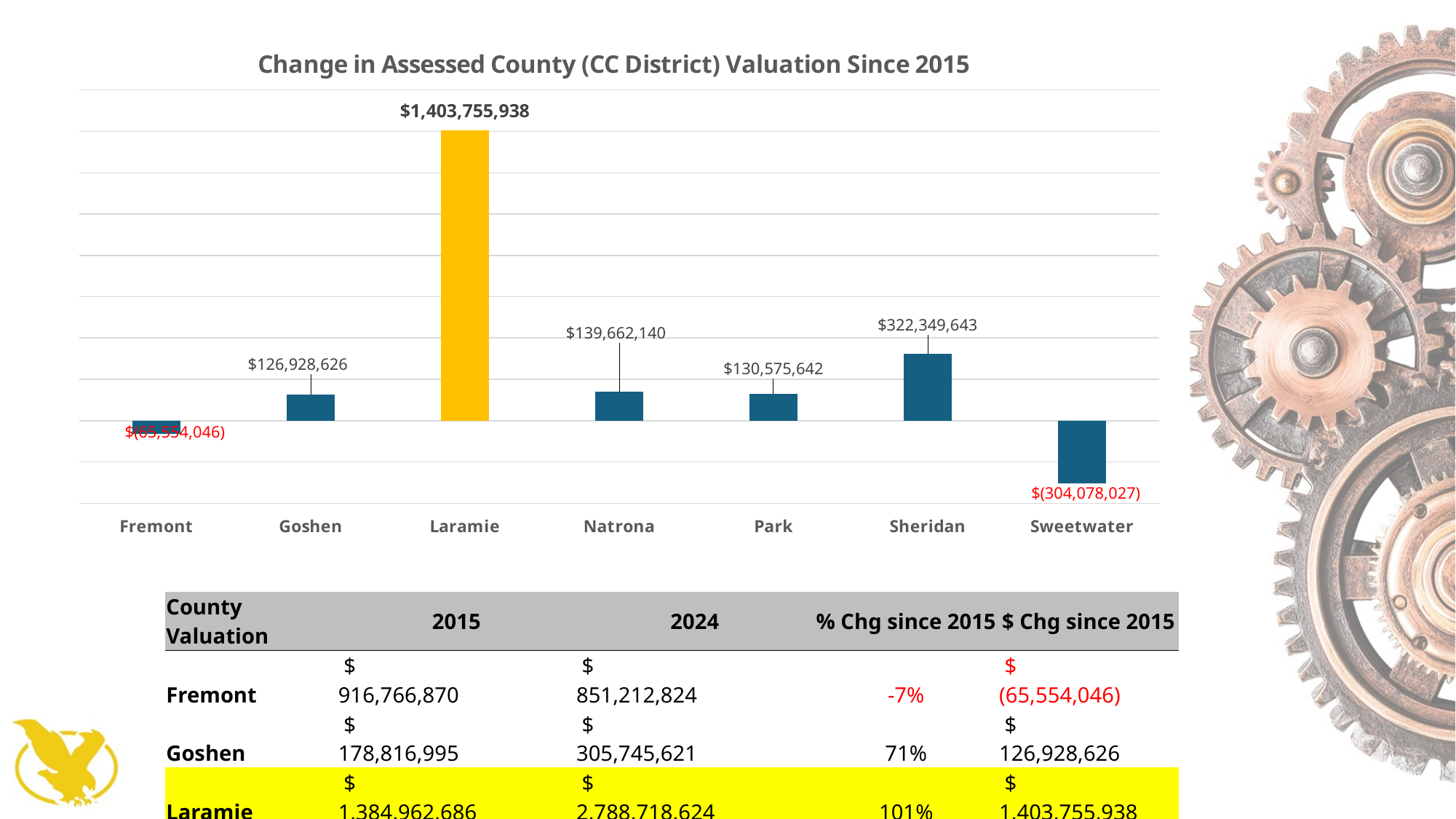
Which county has the largest change in assessed valuation since 2015? Laramie What is the change in assessed valuation since 2015 for Laramie? $1,403,755,938 What is the change in assessed valuation since 2015 for Sheridan? $322,349,643 How many counties are shown in the chart? 7 What is the change in assessed valuation since 2015 for Natrona? $139,662,140 What is the difference between the changes in assessed valuation for Sheridan and Natrona? $182,687,503 Which county has the lowest (most negative) change in assessed valuation since 2015? Sweetwater What is the difference between the changes in assessed valuation for Natrona and Park? $9,086,498 What is the change in assessed valuation since 2015 for Sweetwater? $(304,078,027) What is the change in assessed valuation since 2015 for Goshen? $126,928,626 What type of chart is used to show the change in assessed county valuation? Bar chart Which county has a larger change in assessed valuation since 2015, Park or Goshen? Park